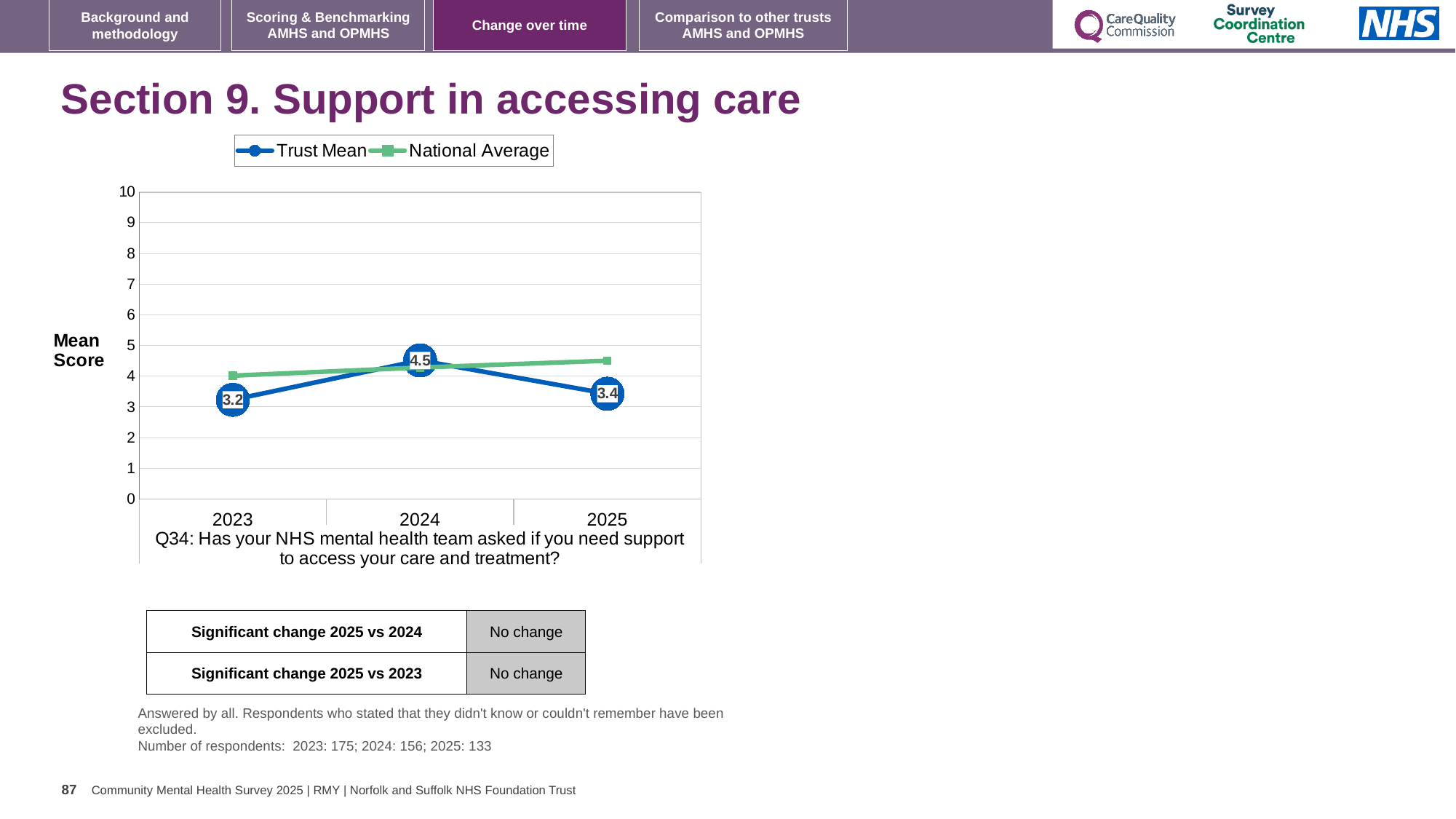
What is the difference between the Trust Mean in 2024 and in 2023? 1.3 What is the Trust Mean score for 2025? 3.4 Does the Trust Mean rise or fall from 2024 to 2025? fall How many years are shown on the x axis? 3 In which year is the Trust Mean lowest? 2023 Is the National Average value for 2025 greater or less than 5? less How many series does the legend list? 2 What kind of chart is shown on the slide? line chart What is the Trust Mean score for 2024? 4.5 Which is larger, the Trust Mean in 2025 or the Trust Mean in 2023? 2025 In which year is the Trust Mean highest? 2024 What is the Trust Mean score for 2023? 3.2